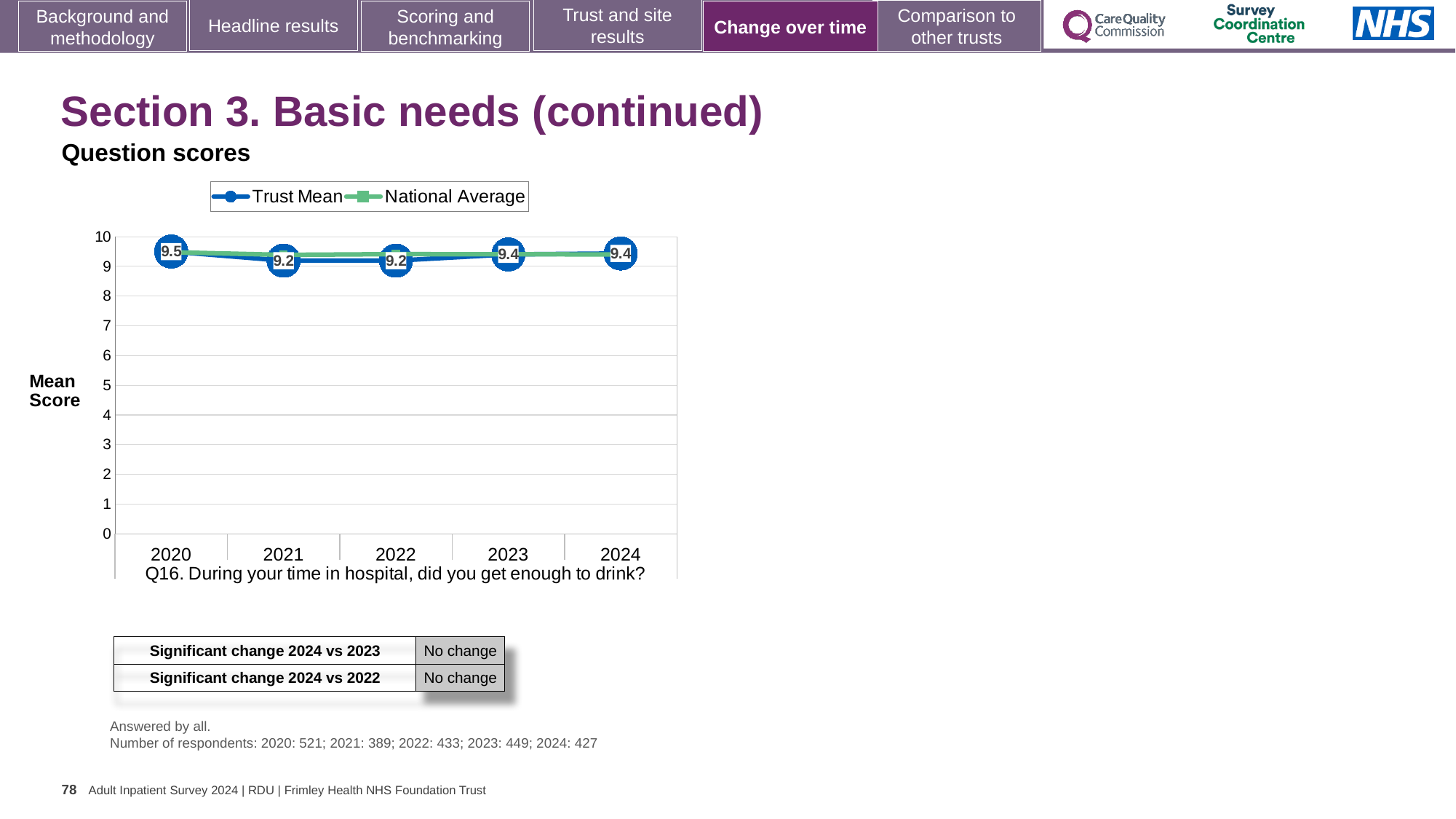
What is the Trust Mean score for 2022? 9.2 What kind of chart is shown on the slide? Line chart How many series does the legend list? 2 In which year is the Trust Mean score highest? 2020 How many years are plotted on the x axis? 5 Does the Trust Mean score rise or fall from 2020 to 2021? Fall What is the Trust Mean score for 2020? 9.5 What is the Trust Mean score for 2024? 9.4 Which year has the larger Trust Mean score, 2021 or 2023? 2023 Is the Trust Mean value for 2024 greater or less than 8? greater What is the lowest Trust Mean score shown on the chart? 9.2 What is the difference between the Trust Mean scores for 2020 and 2021? 0.3